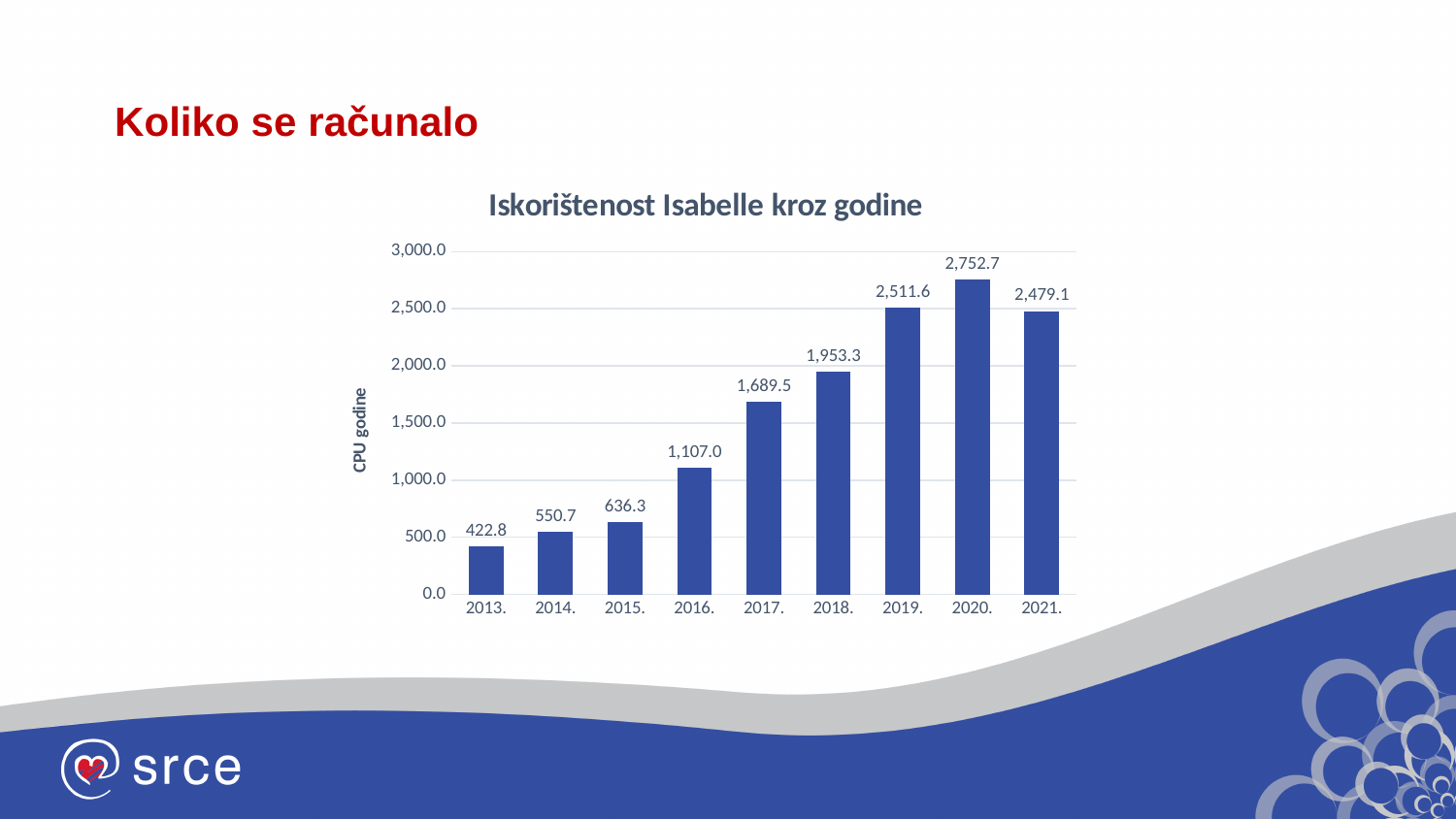
What is the label of the vertical axis? CPU godine What is the value for 2016. in the chart? 1,107.0 What is the value for 2013. in the chart? 422.8 Which is larger, the value for 2021. or the value for 2019.? 2019. How many years are shown on the x axis? 9 Which year has the lowest value? 2013. Which year has the highest value? 2020. What is the difference between the values for 2019. and 2018.? 558.3 Is the value for 2017. greater or less than 1,500.0? greater What kind of chart is shown on the slide? bar chart What is the difference between the values for 2020. and 2021.? 273.6 What is the value for 2019. in the chart? 2,511.6